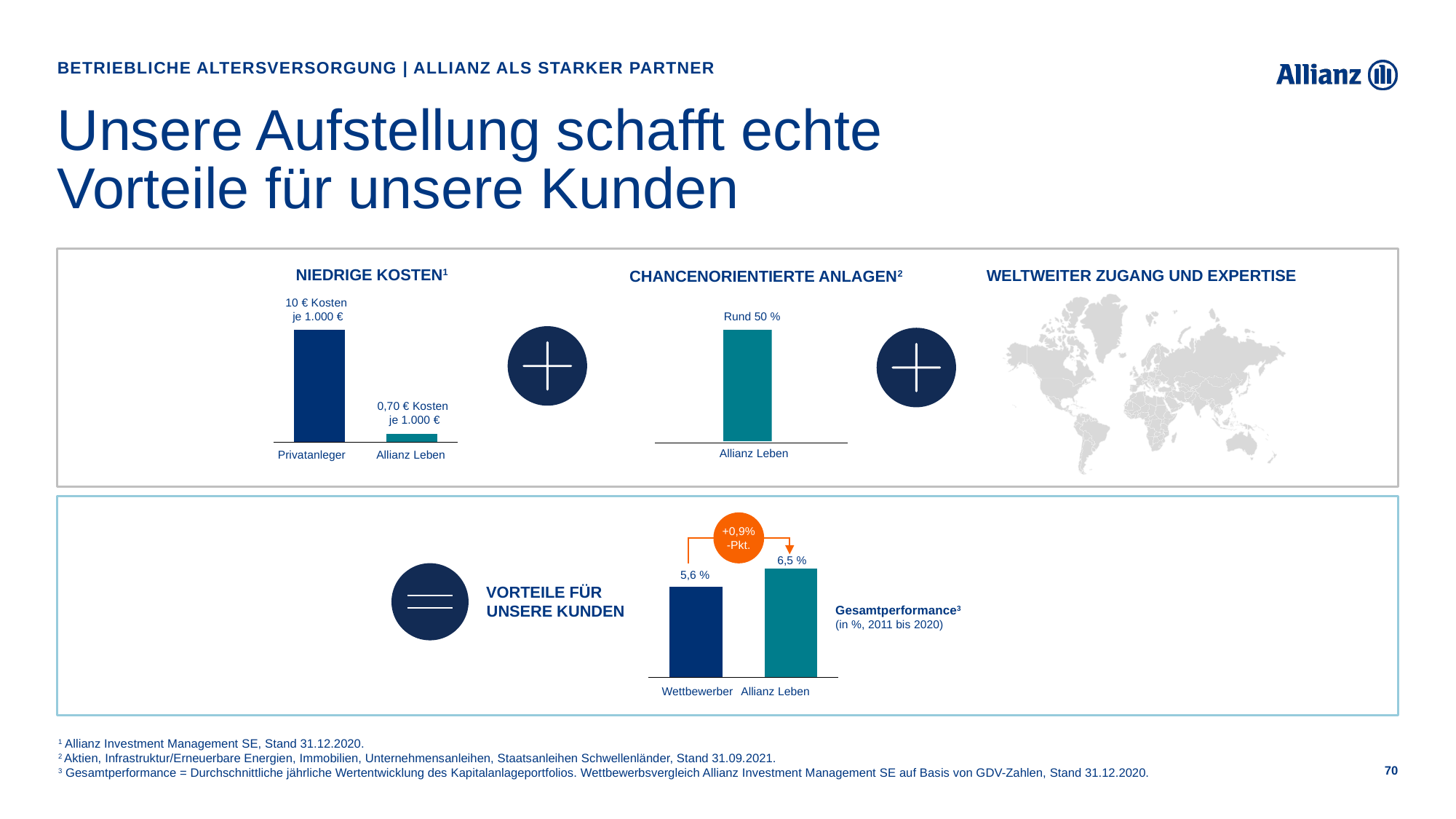
What type of chart is the 'Gesamtperformance' chart? Bar chart In the 'Niedrige Kosten' chart, what is the value shown for Allianz Leben? 0,70 € Kosten je 1.000 € In the 'Gesamtperformance' chart, which category has the higher value? Allianz Leben In the 'Niedrige Kosten' chart, what is the value shown for Privatanleger? 10 € Kosten je 1.000 € In the 'Chancenorientierte Anlagen' chart, how many bars are shown? 1 In the 'Gesamtperformance' chart, what is the value for Allianz Leben? 6,5 % In the 'Gesamtperformance' chart, what is the value for Wettbewerber? 5,6 % In the 'Gesamtperformance' chart, what is the difference between Allianz Leben and Wettbewerber as labelled on the slide? +0,9%-Pkt. In the 'Chancenorientierte Anlagen' chart, what value is shown for Allianz Leben? Rund 50 % What period does the 'Gesamtperformance' chart cover according to its subtitle? 2011 bis 2020 In the 'Niedrige Kosten' chart, how many categories are shown? 2 In the 'Niedrige Kosten' chart, which category has the higher cost? Privatanleger